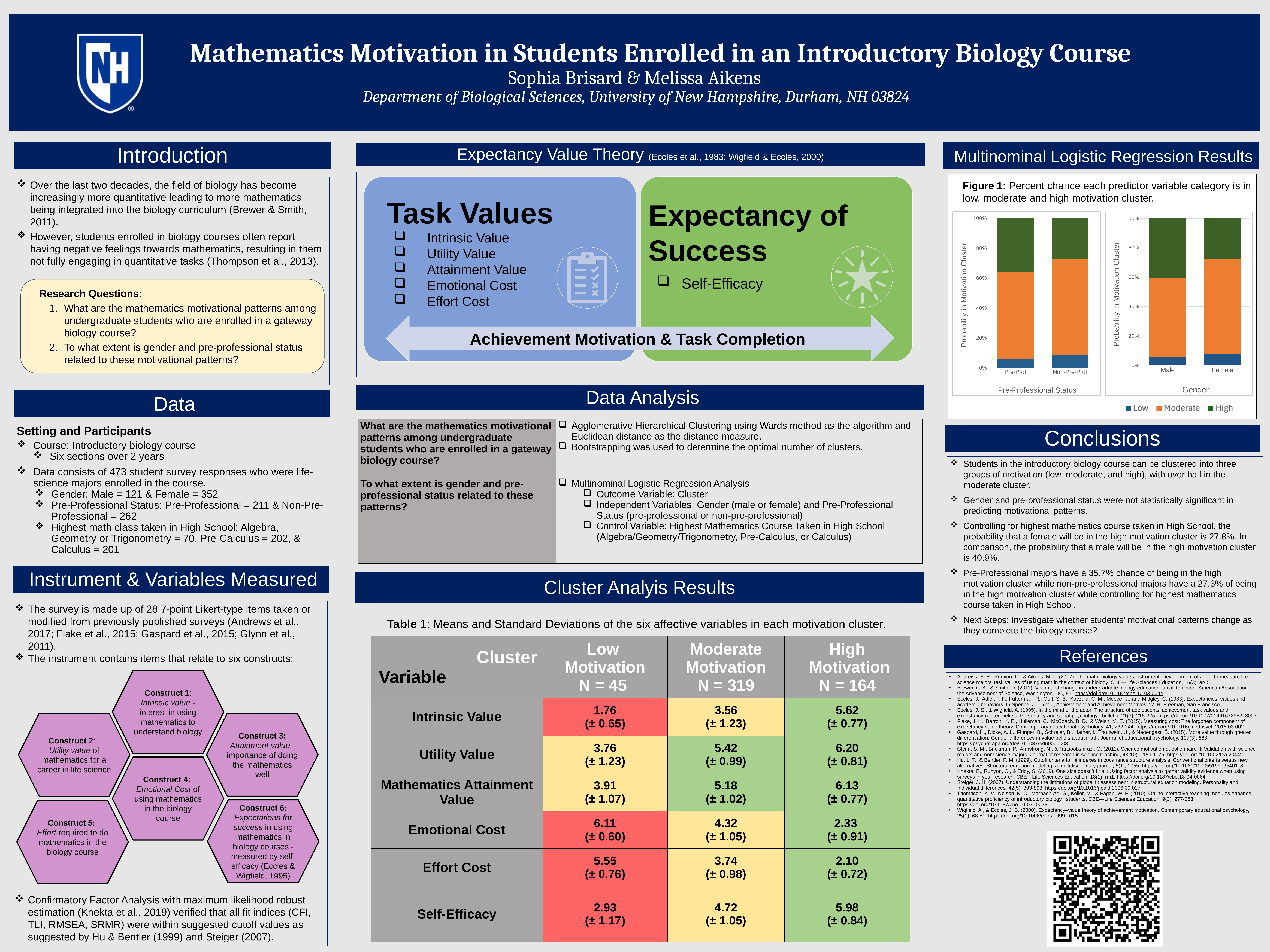
What kind of chart is used in Figure 1 for Pre-Professional Status? Stacked bar chart In the Pre-Professional Status chart of Figure 1, which category has the larger High segment, Pre-Prof or Non-Pre-Prof? Pre-Prof In the Gender chart of Figure 1, which category has the larger High segment, Male or Female? Male In the Gender chart of Figure 1, what is the total height of the stacked bar for Male? 100% In the Gender chart of Figure 1, which category has the larger Moderate segment, Male or Female? Female How many categories are shown on the x axis of the Gender chart in Figure 1? 2 In the Gender chart of Figure 1, is the High segment for Male greater or less than 20%? greater What is the y-axis label of the charts in Figure 1? Probability in Motivation Cluster In the Gender chart of Figure 1, does the top of the Moderate segment for Female lie above or below 60%? above How many series does the legend of Figure 1 list? 3 What are the legend entries in Figure 1? Low, Moderate, High In the Pre-Professional Status chart of Figure 1, is the Low segment for Pre-Prof greater or less than 20%? less